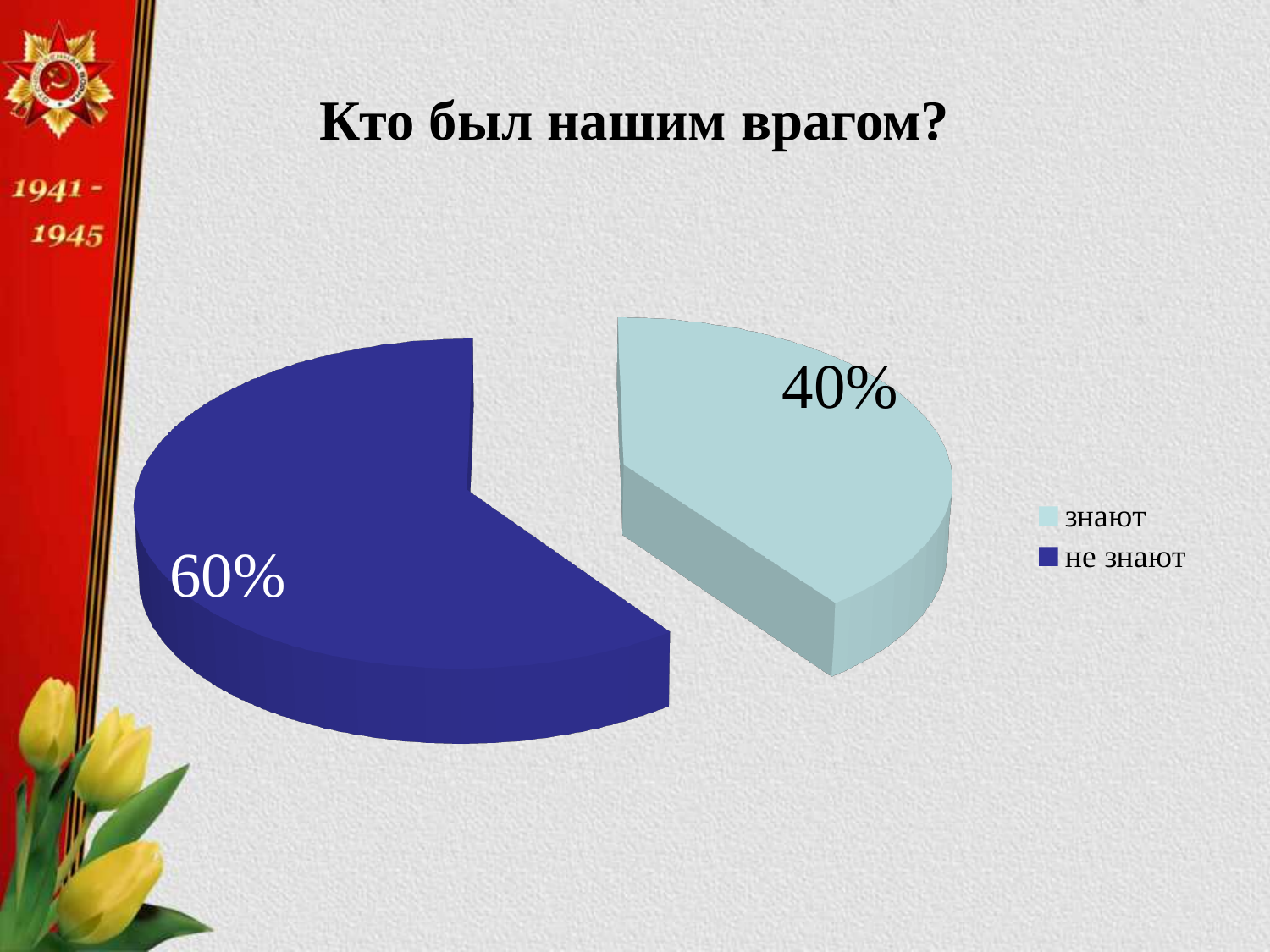
What is the title of the chart? Кто был нашим врагом? What colour is the "не знают" slice? dark blue What is the value for "знают"? 40% How many entries does the legend list? 2 Which category has the largest share of the pie? не знают Which is larger, the share for "знают" or the share for "не знают"? не знают How many slices does the pie chart have? 2 Which category has the smallest share of the pie? знают What is the value for "не знают"? 60% What is the difference between the shares of "не знают" and "знают"? 20% What share of the pie does the "знают" slice represent? 40% What kind of chart is shown on the slide? pie chart